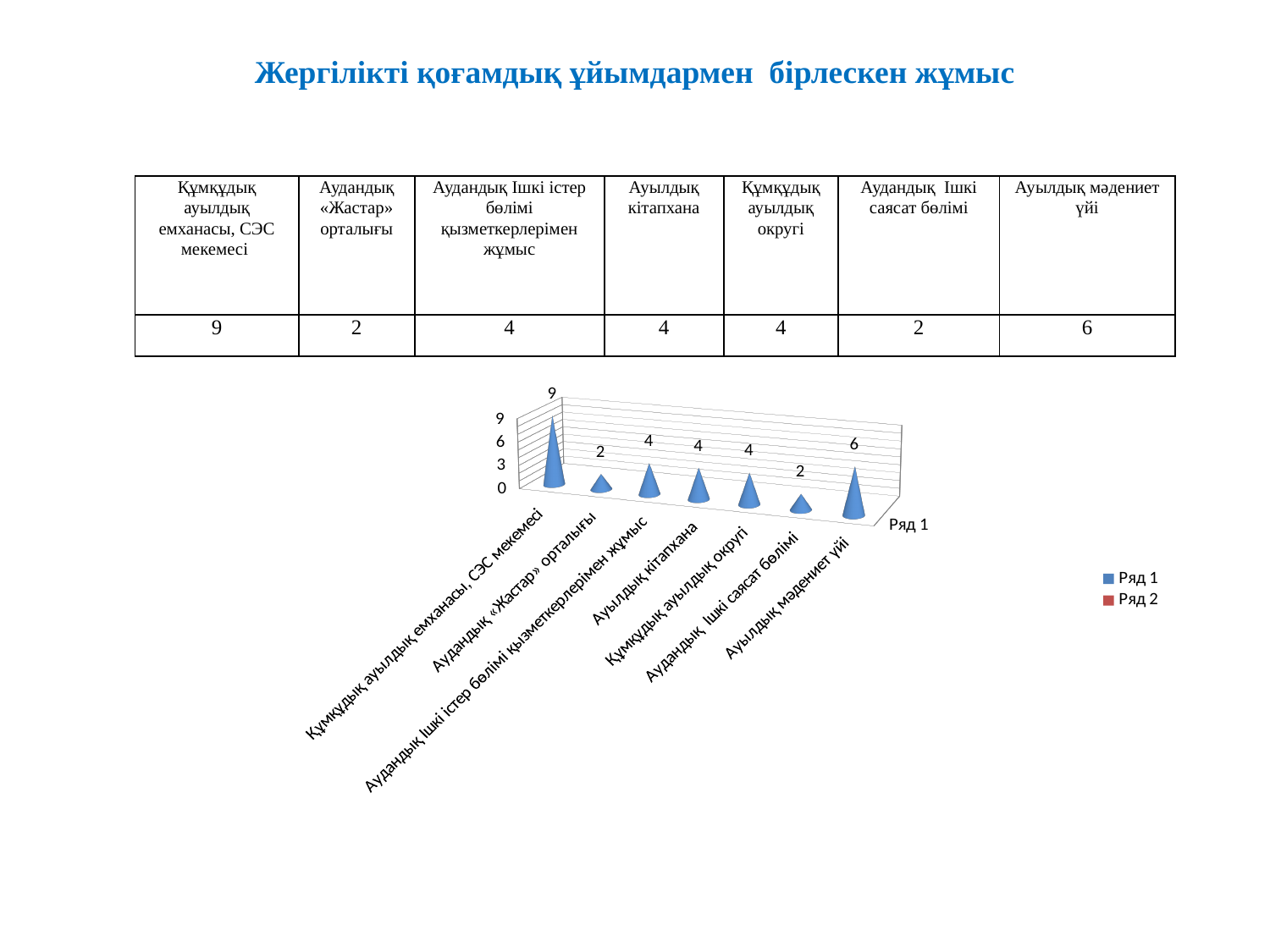
Which is larger: the value for Құмқұдық ауылдық округі or the value for Аудандық Ішкі саясат бөлімі? Құмқұдық ауылдық округі What kind of chart is shown on the slide? 3D bar chart (cone) How many categories are plotted in the chart? 7 What is the difference between the values for Құмқұдық ауылдық емханасы, СЭС мекемесі and Ауылдық мәдениет үйі? 3 What is the value for Құмқұдық ауылдық емханасы, СЭС мекемесі in the chart? 9 What is the value for Аудандық «Жастар» орталығы in the chart? 2 What is the title of the slide above the chart? Жергілікті қоғамдық ұйымдармен бірлескен жұмыс What is the value for Ауылдық мәдениет үйі in the chart? 6 How many series does the chart legend list? 2 Which is larger: the value for Ауылдық мәдениет үйі or the value for Ауылдық кітапхана? Ауылдық мәдениет үйі Which category has the highest value in the chart? Құмқұдық ауылдық емханасы, СЭС мекемесі What is the value for Ауылдық кітапхана in the chart? 4